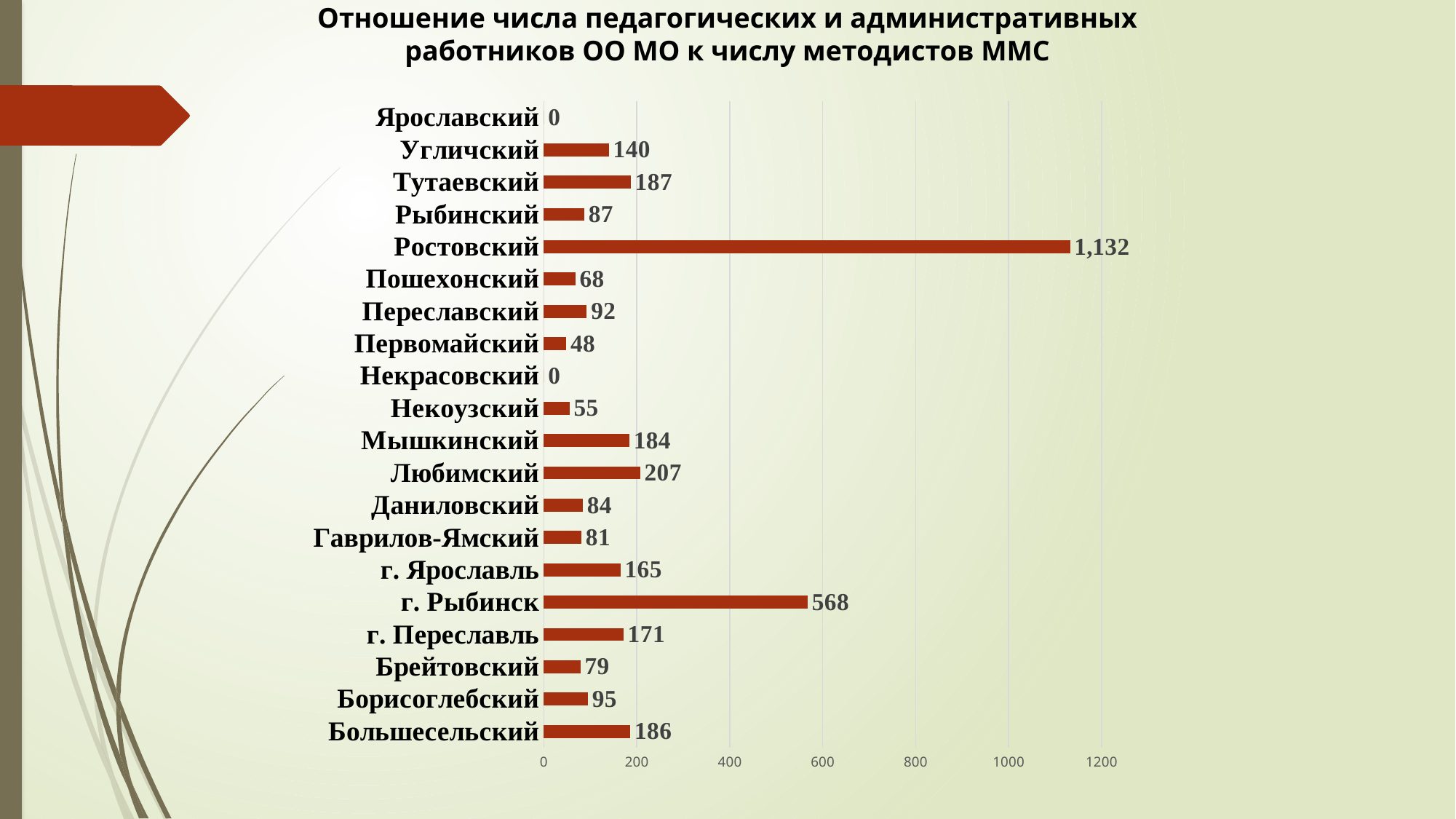
What is the difference between the values for Любимский and Угличский? 67 What is the value for Угличский? 140 Is the value for г. Ярославль greater or less than 200? less What is the difference between the values for Ростовский and г. Рыбинск? 564 Which is larger, the value for Тутаевский or the value for Мышкинский? Тутаевский What is the value for Ростовский? 1,132 How many categories are shown in the chart? 20 What is the value for г. Рыбинск? 568 What kind of chart is shown on the slide? bar chart Which category has the highest value? Ростовский What is the value for Некрасовский? 0 What is the value for Большесельский? 186